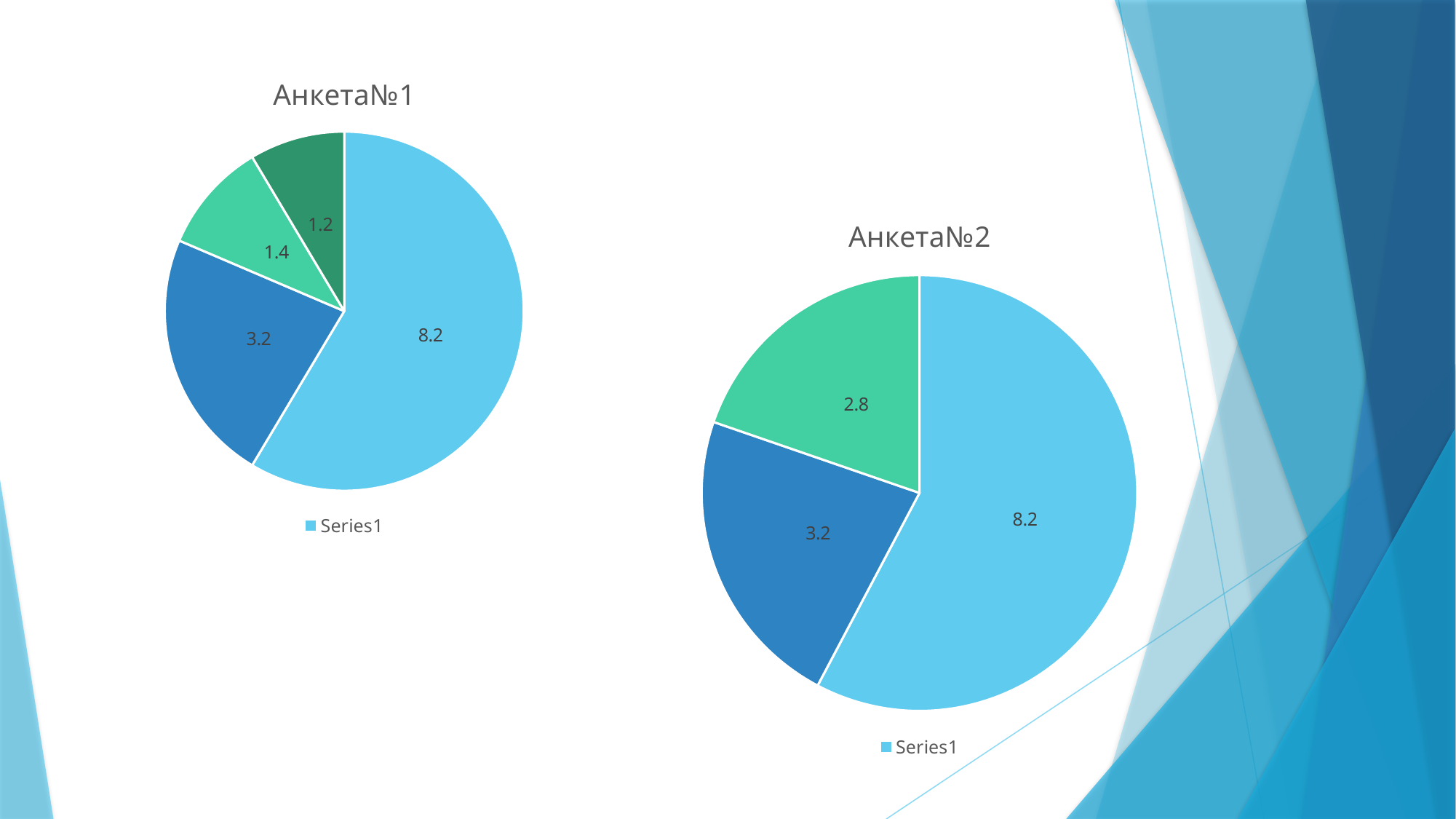
In the "Анкета№2" chart, what is the difference between the largest slice and the smallest slice? 5.4 In the "Анкета№1" chart, what is the value of the smallest slice? 1.2 How many series does the legend of the "Анкета№2" chart list? 1 In the "Анкета№2" chart, what is the value of the largest slice? 8.2 In the "Анкета№2" chart, what is the value of the smallest slice? 2.8 What kind of chart is "Анкета№1"? pie chart In the "Анкета№1" chart, what is the value of the largest slice? 8.2 How many slices does the "Анкета№2" pie chart have? 3 What is the legend entry shown under the "Анкета№1" chart? Series1 In the "Анкета№1" chart, what is the difference between the largest slice and the smallest slice? 7.0 How many slices does the "Анкета№1" pie chart have? 4 Which is larger: the smallest slice in "Анкета№1" or the smallest slice in "Анкета№2"? the smallest slice in Анкета№2